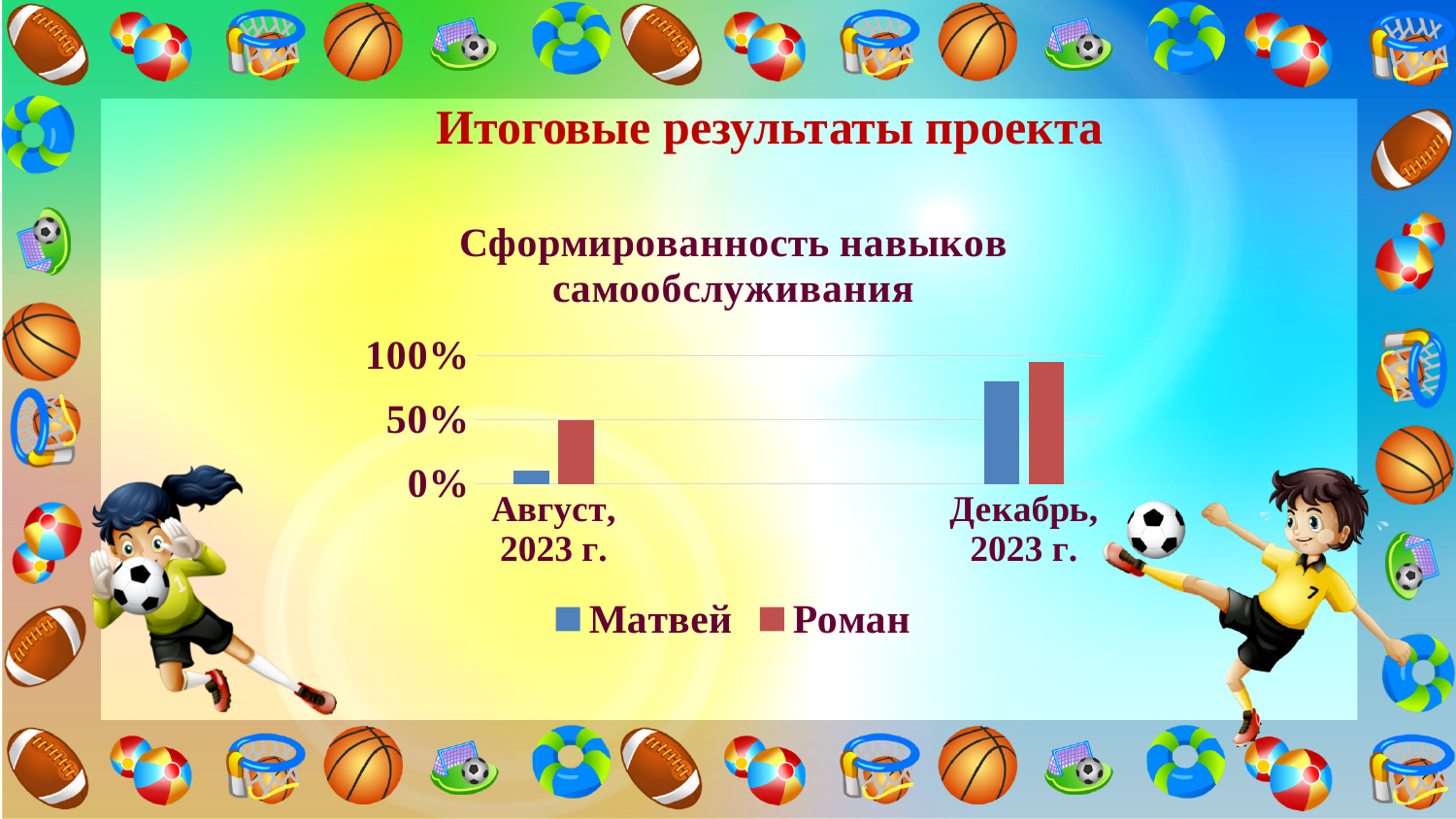
How many categories are shown on the x axis of the chart? 2 Do the values for Матвей rise or fall from Август, 2023 г. to Декабрь, 2023 г.? rise Is the value for Матвей in Декабрь, 2023 г. greater or less than 50%? greater What is the title of the chart? Сформированность навыков самообслуживания In Декабрь, 2023 г., which is larger: the value for Матвей or the value for Роман? Роман Is the value for Матвей in Август, 2023 г. greater or less than 50%? less What kind of chart is shown on the slide? bar chart In Август, 2023 г., which is larger: the value for Матвей or the value for Роман? Роман Which bar in the chart is the lowest? Матвей, Август, 2023 г. Which series are listed in the chart legend? Матвей, Роман Is the value for Роман in Декабрь, 2023 г. greater or less than 50%? greater How many series does the chart legend list? 2